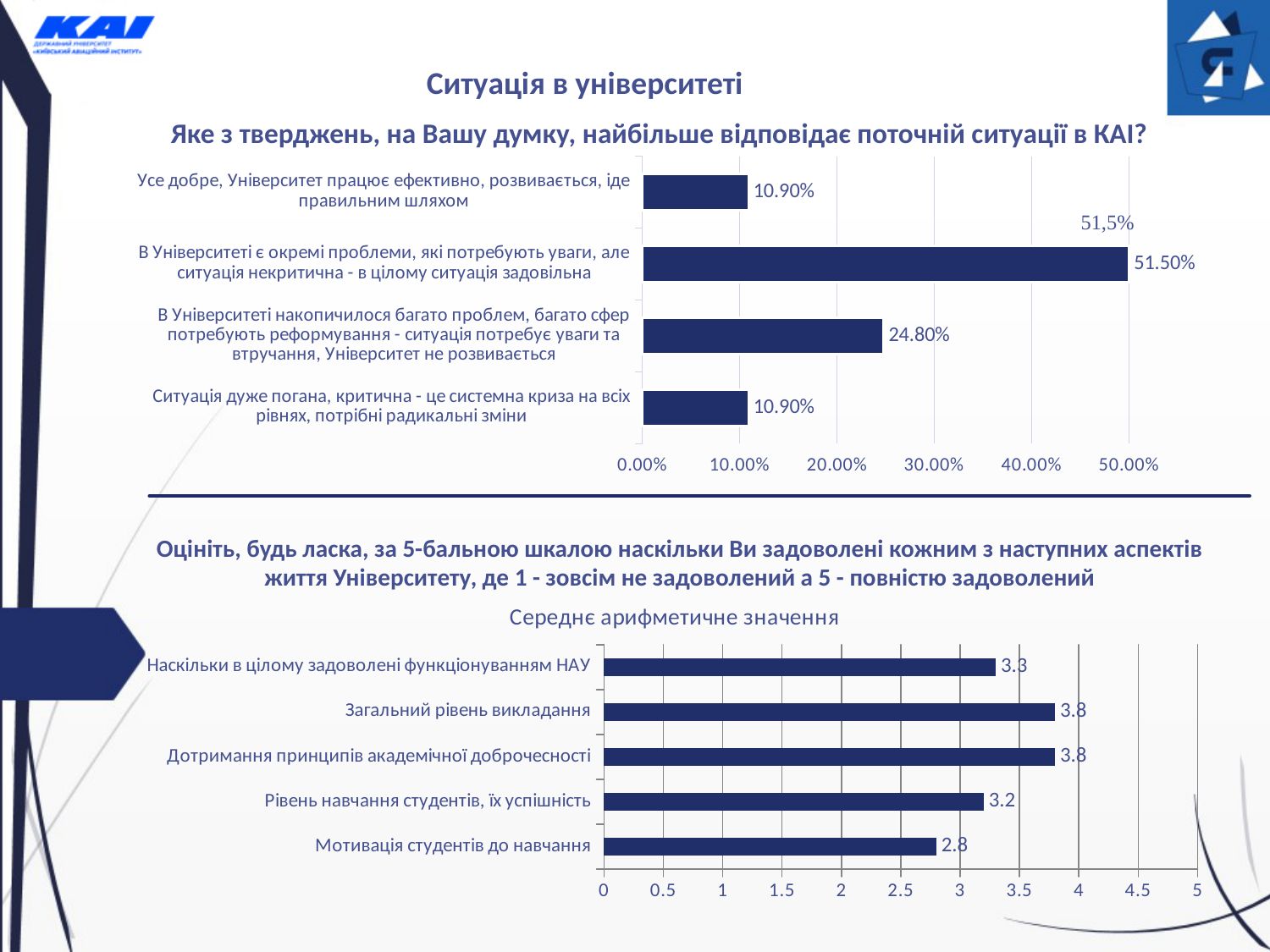
In the bottom chart "Середнє арифметичне значення", what is the value for "Наскільки в цілому задоволені функціонуванням НАУ"? 3.3 In the bottom chart "Середнє арифметичне значення", what is the value for "Мотивація студентів до навчання"? 2.8 In the bottom chart "Середнє арифметичне значення", what is the difference between the value for "Дотримання принципів академічної доброчесності" and the value for "Мотивація студентів до навчання"? 1.0 In the bottom chart "Середнє арифметичне значення", which category has the lowest value? Мотивація студентів до навчання In the top chart, which statement has the highest value? В Університеті є окремі проблеми, які потребують уваги, але ситуація некритична - в цілому ситуація задовільна How many categories are shown in the top chart? 4 In the bottom chart "Середнє арифметичне значення", which is larger: the value for "Загальний рівень викладання" or the value for "Рівень навчання студентів, їх успішність"? Загальний рівень викладання In the top chart, what is the difference between the value for "В Університеті є окремі проблеми..." and the value for "В Університеті накопичилося багато проблем..."? 26.70% In the top chart, what is the value for "В Університеті є окремі проблеми, які потребують уваги, але ситуація некритична - в цілому ситуація задовільна"? 51.50% In the top chart, what is the value for "В Університеті накопичилося багато проблем, багато сфер потребують реформування - ситуація потребує уваги та втручання, Університет не розвивається"? 24.80% How many categories are shown in the bottom chart "Середнє арифметичне значення"? 5 What kind of chart is the top chart? Bar chart